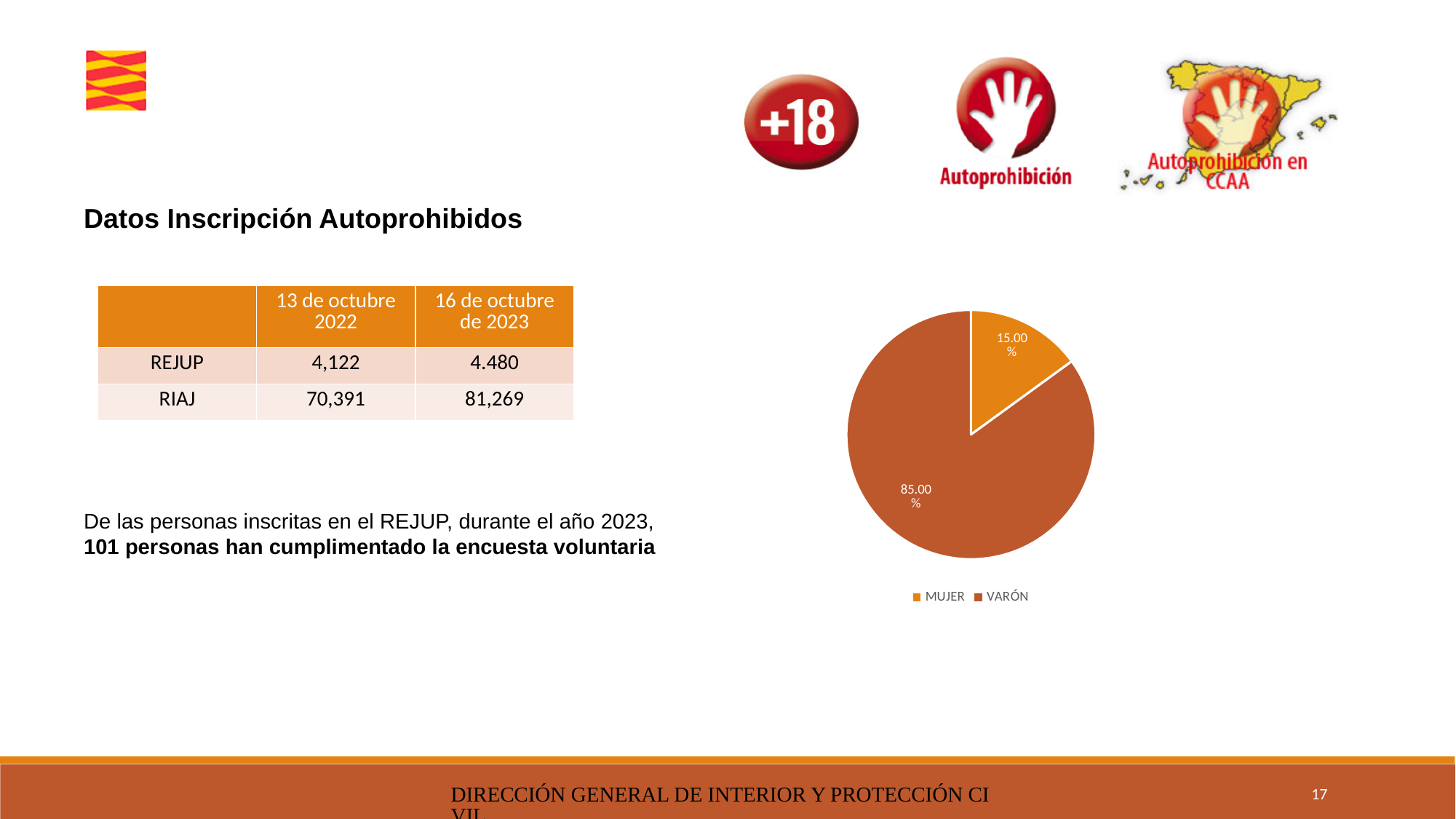
Which category is shown in the lighter orange colour in the pie chart? MUJER What share of the pie chart does MUJER represent? 15.00% What are the two categories listed in the pie chart legend? MUJER and VARÓN What kind of chart is shown on the slide? pie chart How many slices does the pie chart have? 2 Which is larger in the pie chart, MUJER or VARÓN? VARÓN Which category has the smallest slice in the pie chart? MUJER What is the difference in percentage points between the VARÓN and MUJER slices? 70.00% How many entries does the pie chart legend list? 2 What share of the pie chart does VARÓN represent? 85.00% Which category has the largest slice in the pie chart? VARÓN